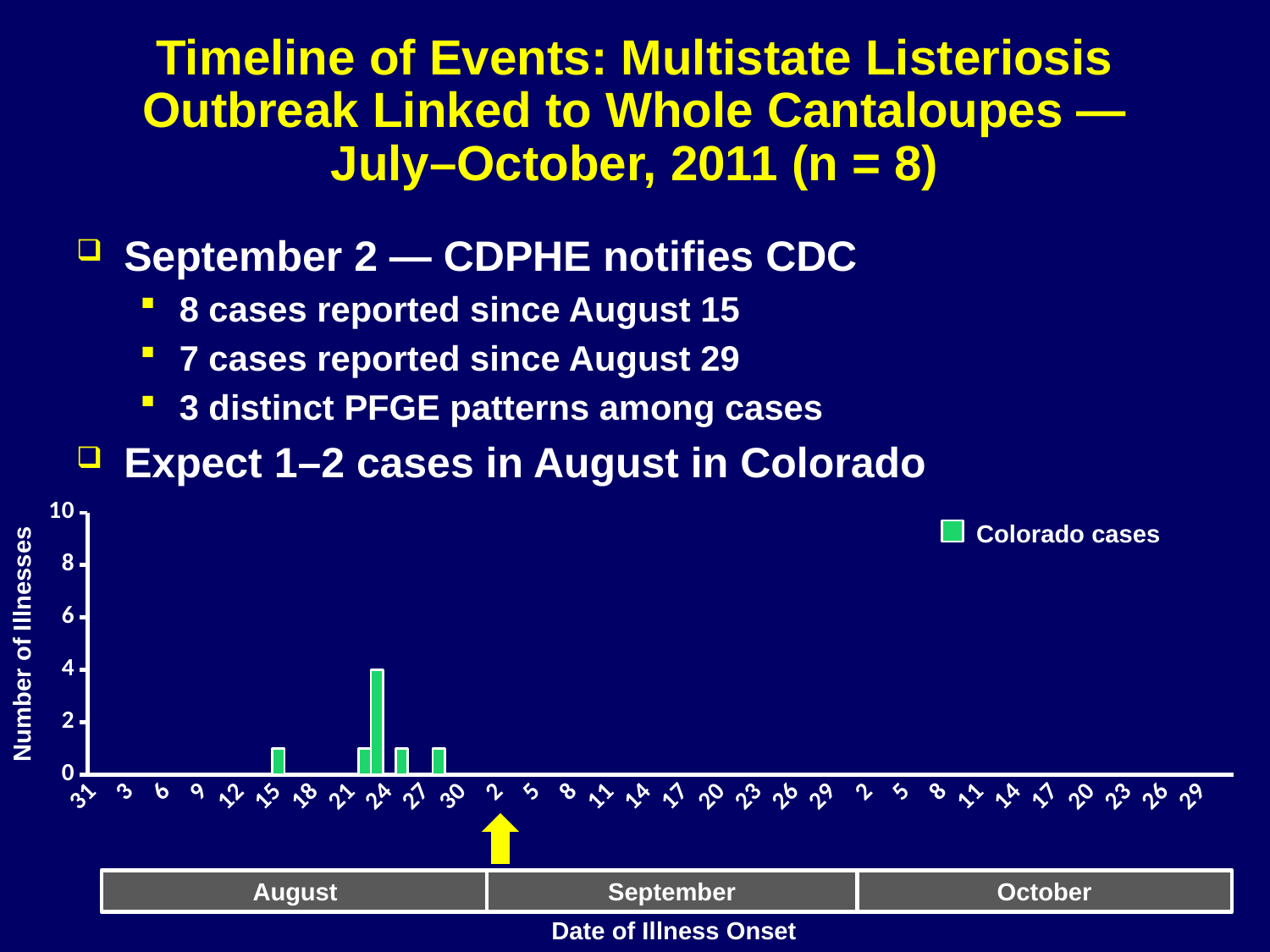
How many bars are plotted in the chart? 5 What is the name of the series shown in the chart legend? Colorado cases What is the title of the vertical axis of the chart? Number of Illnesses How many series does the chart legend list? 1 Is the number of illnesses for August 15 greater or less than 2? less What kind of chart is shown on the slide? bar chart How many bars are plotted in the October section of the chart? 0